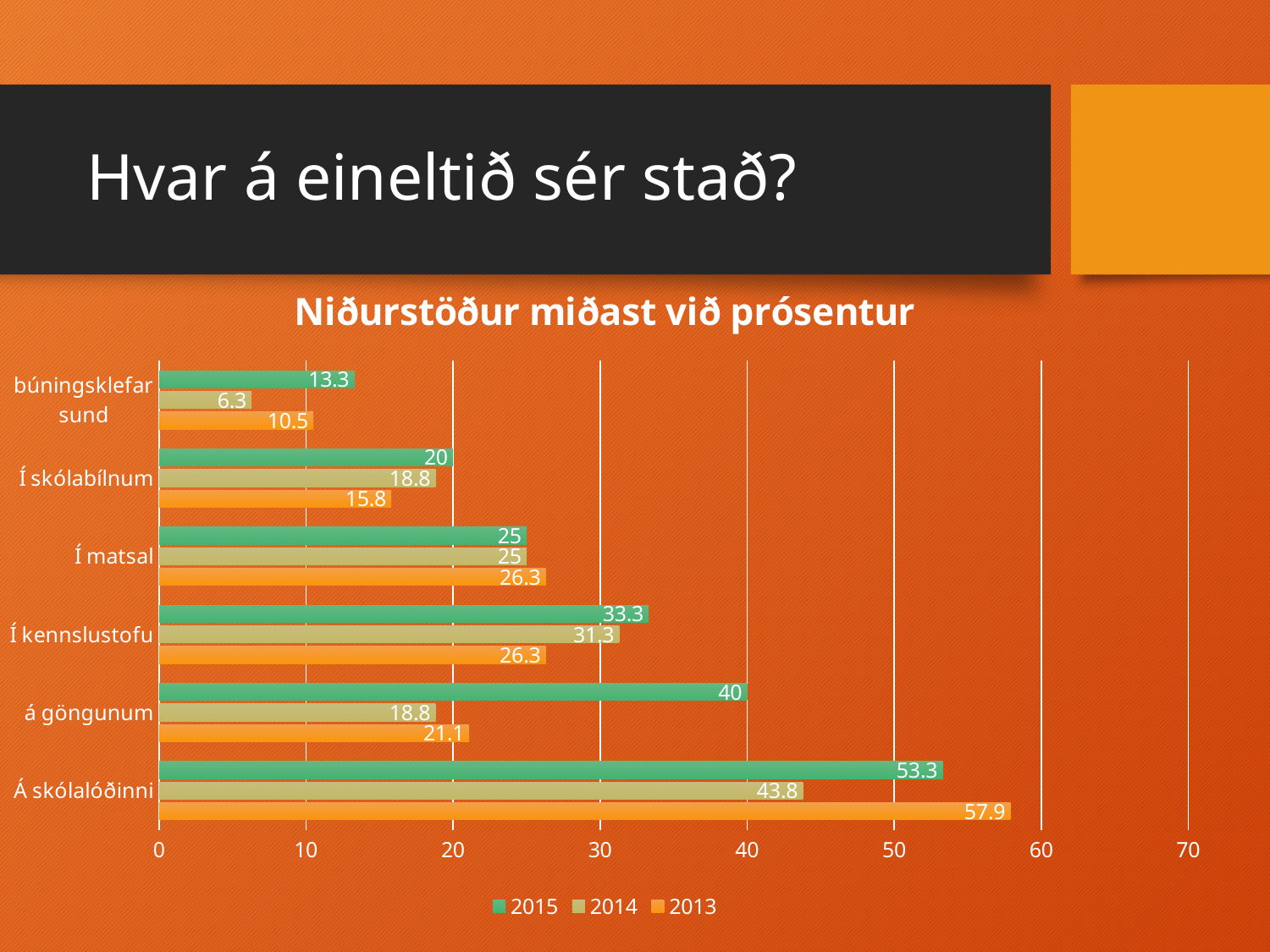
Which category has the highest 2013 value? Á skólalóðinni How many series does the legend list? 3 Is the 2013 value for Á skólalóðinni greater or less than 50? greater What is the difference between the 2015 and 2014 values for á göngunum? 21.2 What kind of chart is shown on the slide? bar chart What is the title of the chart? Niðurstöður miðast við prósentur What is the 2014 value for Í kennslustofu? 31.3 What is the 2015 value for Á skólalóðinni? 53.3 Which category has the lowest 2014 value? búningsklefar sund How many categories are shown on the chart? 6 Which is larger for Í matsal: the 2013 value or the 2015 value? 2013 What is the 2013 value for búningsklefar sund? 10.5